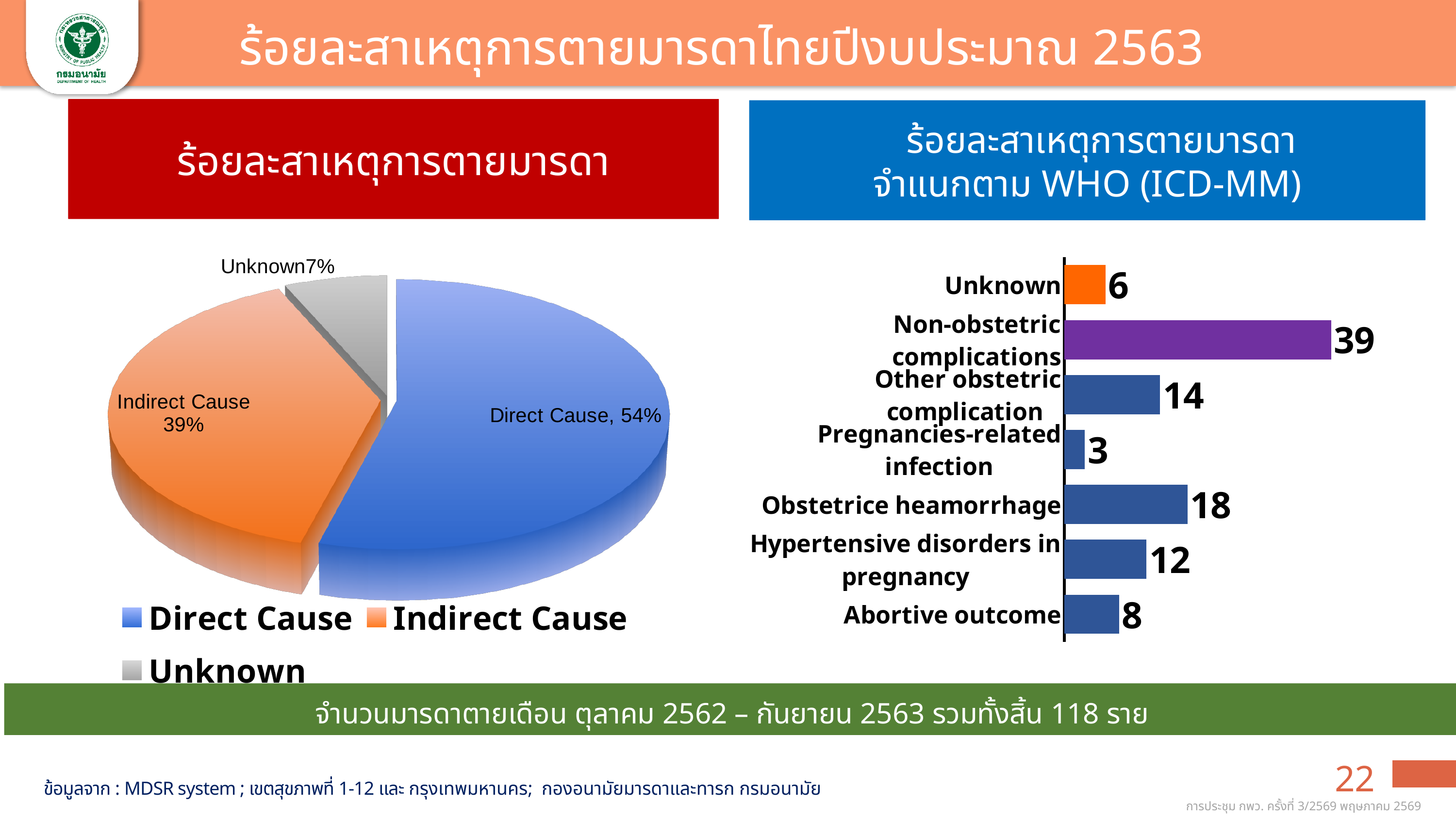
In the bar chart on the right, what is the difference between Other obstetric complication and Hypertensive disorders in pregnancy? 2 In the pie chart on the left, what share is labelled for Unknown? 7% What kind of chart is the chart on the left of the slide? Pie chart In the pie chart on the left, what share is labelled for Direct Cause? 54% In the bar chart on the right, how many categories are shown? 7 In the pie chart on the left, what share is labelled for Indirect Cause? 39% In the pie chart on the left, which slice is the largest? Direct Cause In the bar chart on the right, which category has the lowest value? Pregnancies-related infection In the pie chart on the left, how many slices does the pie have? 3 In the bar chart on the right, what is the value for Non-obstetric complications? 39 In the bar chart on the right, what is the value for Obstetrice heamorrhage? 18 In the bar chart on the right, which is larger: Abortive outcome or Unknown? Abortive outcome